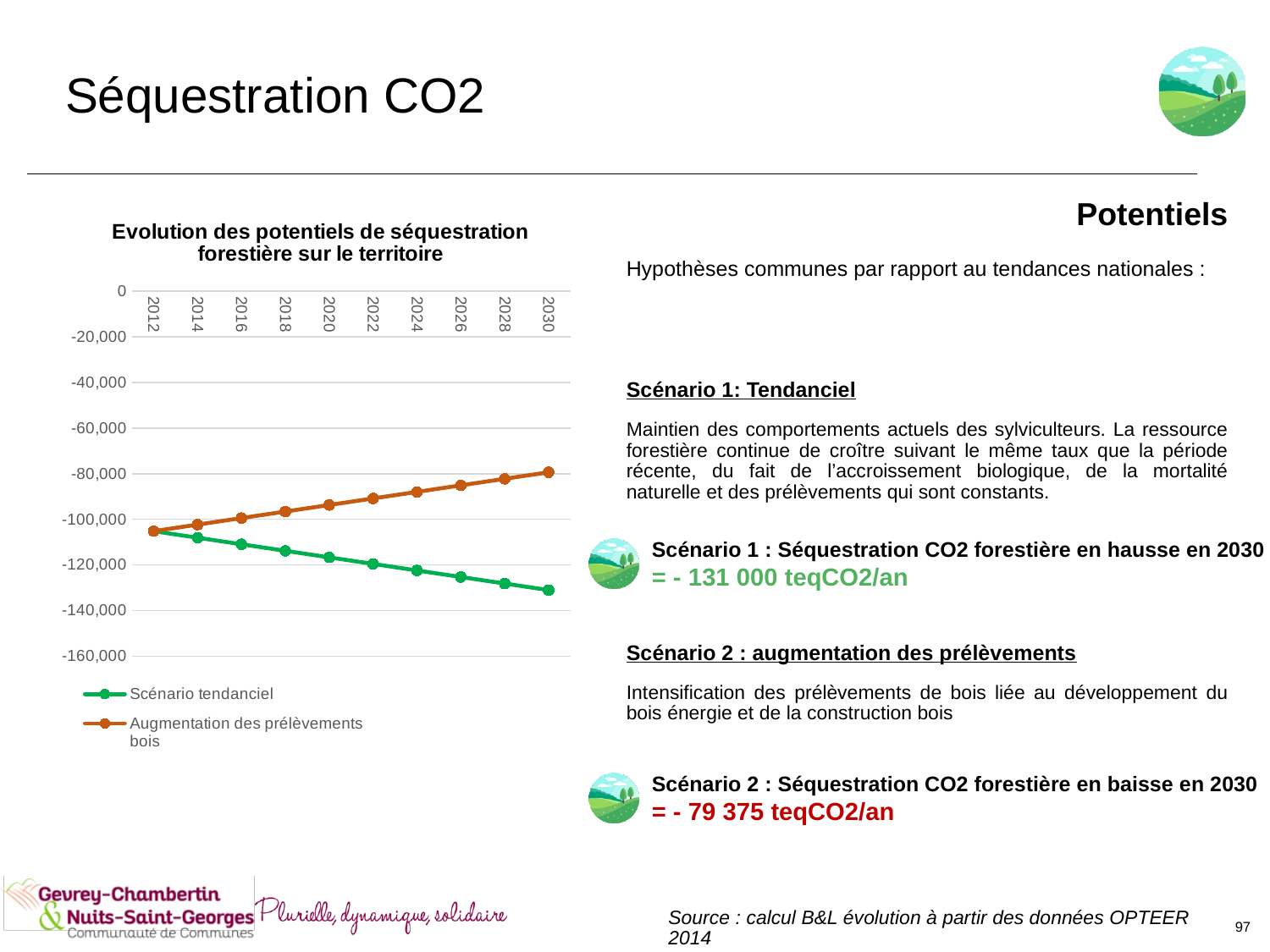
Do the values of the 'Scénario tendanciel' series rise or fall from 2012 to 2030? fall How many series does the chart legend list? 2 What is the title of the chart? Evolution des potentiels de séquestration forestière sur le territoire What kind of chart is shown on the slide? line chart How many years are plotted along the x axis of the chart? 10 Is the value for 'Augmentation des prélèvements bois' in 2030 greater or less than -100,000? greater In which year does the 'Scénario tendanciel' series reach its lowest value? 2030 In 2030, which series has the higher value: 'Scénario tendanciel' or 'Augmentation des prélèvements bois'? Augmentation des prélèvements bois In which year does the 'Augmentation des prélèvements bois' series reach its highest value? 2030 Which series is drawn in green in the chart? Scénario tendanciel Do the values of the 'Augmentation des prélèvements bois' series rise or fall from 2012 to 2030? rise Is the value for 'Scénario tendanciel' in 2030 greater or less than -120,000? less